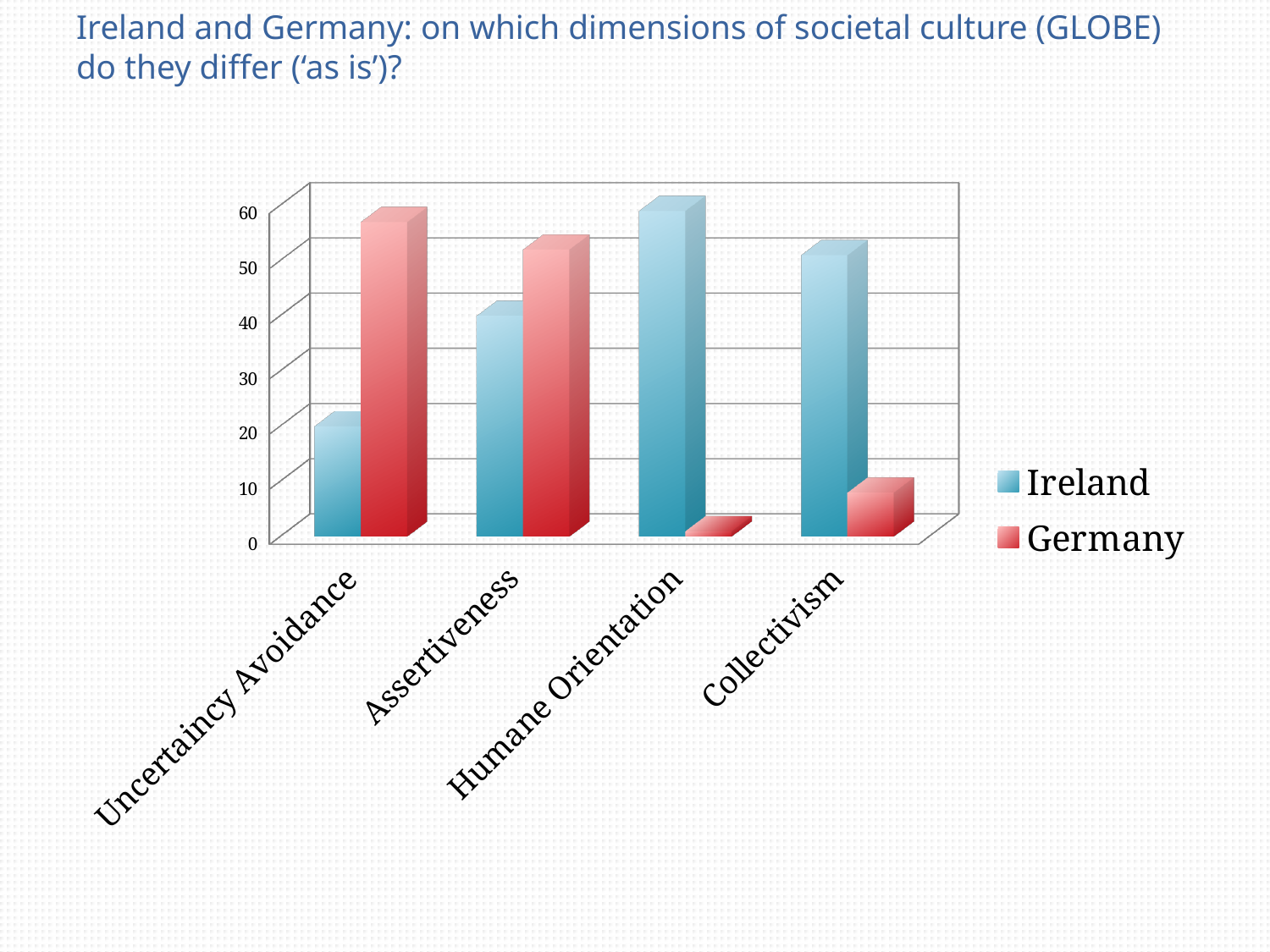
For Humane Orientation, which country has the larger value, Ireland or Germany? Ireland Is the value for Ireland on Uncertaincy Avoidance greater or less than 30? less For Collectivism, which country has the larger value, Ireland or Germany? Ireland Which series is shown in red? Germany Is the value for Germany on Humane Orientation greater or less than 10? less What kind of chart is shown on the slide? bar chart How many series does the legend list? 2 On which dimension is Germany's value lowest? Humane Orientation On which dimension is Ireland's value highest? Humane Orientation On which dimension is Ireland's value lowest? Uncertaincy Avoidance For Uncertaincy Avoidance, which country has the larger value, Ireland or Germany? Germany How many cultural dimensions (categories) are shown on the x axis? 4